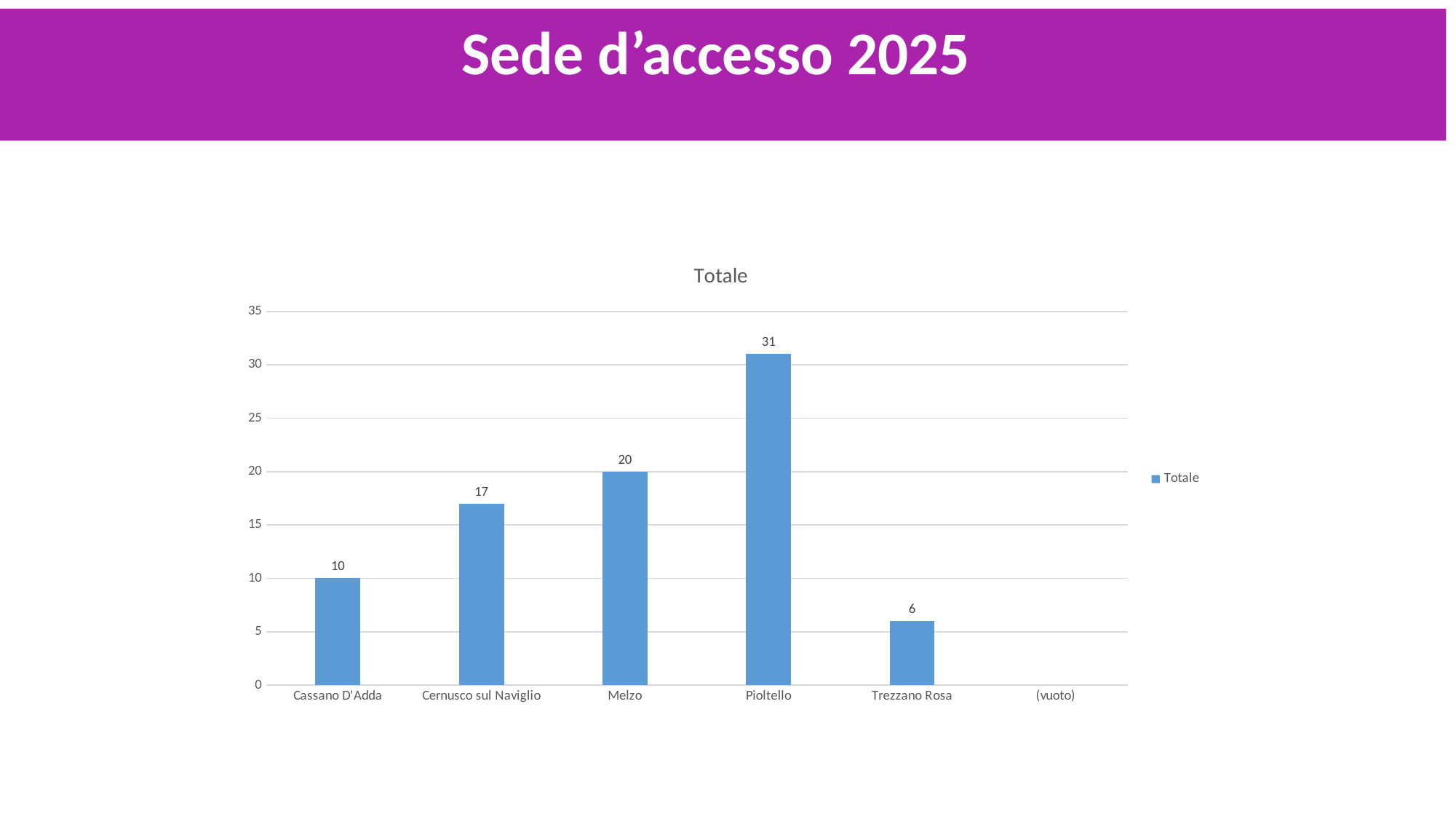
Is the value for Melzo greater or less than 15? greater What is the value for Pioltello? 31 Which category with a visible bar has the lowest value? Trezzano Rosa What is the value for Trezzano Rosa? 6 What kind of chart is shown on the slide? Bar chart What is the difference between the values for Pioltello and Melzo? 11 What is the title of the chart? Totale Which is larger, the value for Cassano D'Adda or the value for Cernusco sul Naviglio? Cernusco sul Naviglio What is the value for Cernusco sul Naviglio? 17 How many series does the legend list? 1 Which category has the highest value? Pioltello How many categories are shown on the x axis? 6